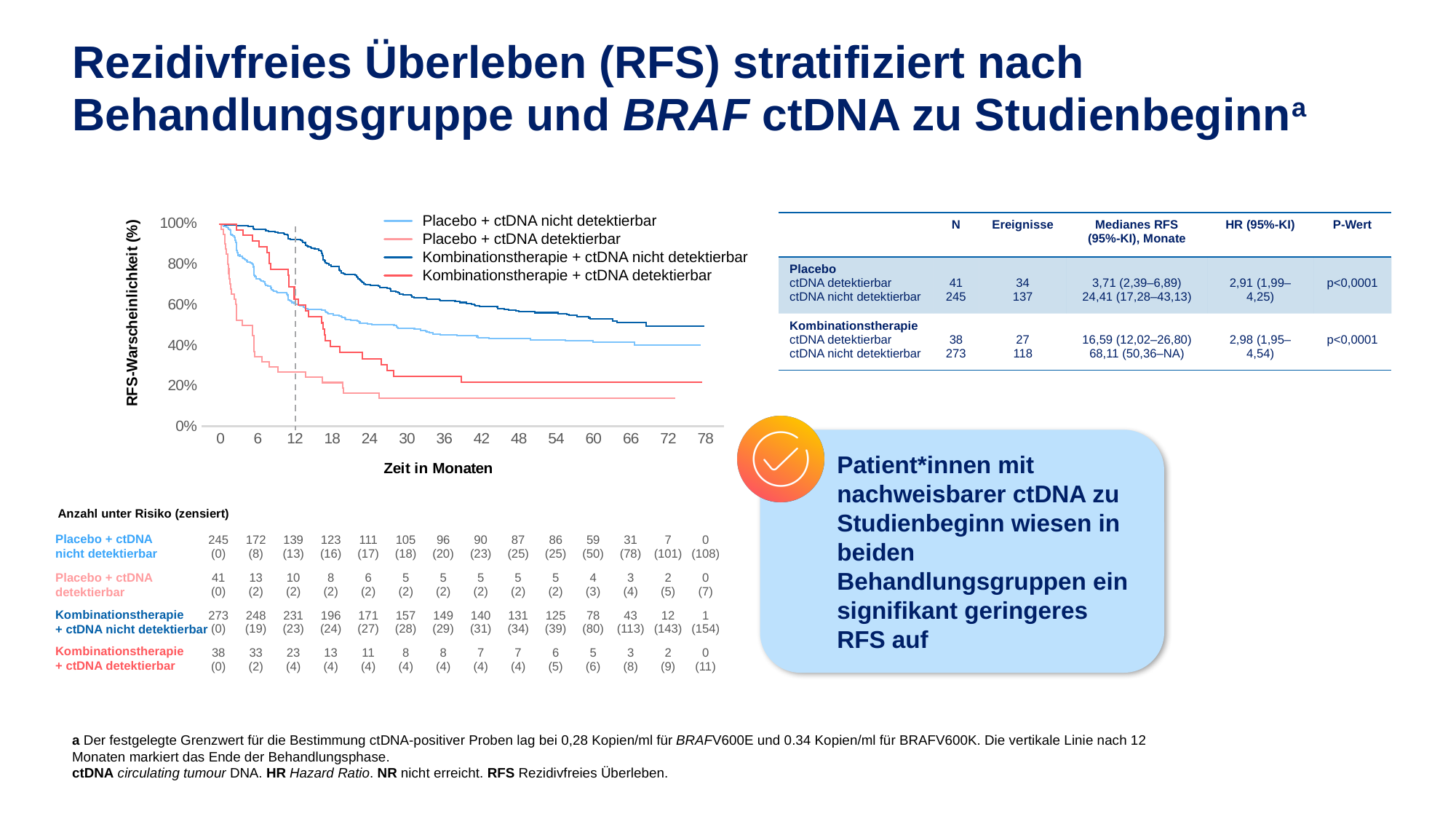
Is the RFS probability for Kombinationstherapie + ctDNA nicht detektierbar at 12 months greater or less than 80%? greater What is the label of the x axis of the RFS chart? Zeit in Monaten How many series does the legend of the RFS chart list? 4 At which month is the vertical dashed line in the RFS chart placed? 12 In the 'Anzahl unter Risiko' table below the chart, how many patients in the Placebo + ctDNA nicht detektierbar group are at risk at 0 months? 245 In the 'Anzahl unter Risiko' table below the chart, how many patients in the Kombinationstherapie + ctDNA nicht detektierbar group are at risk at 24 months? 171 Which series has the lowest RFS probability at 36 months? Placebo + ctDNA detektierbar Is the RFS probability for Kombinationstherapie + ctDNA nicht detektierbar at 72 months greater or less than 40%? greater Do the RFS curves rise or fall along the x axis? Fall Is the RFS probability for Placebo + ctDNA detektierbar at 12 months greater or less than 40%? less What kind of chart is shown on the left of the slide? Line chart (Kaplan-Meier curve) Which series has the highest RFS probability at 36 months? Kombinationstherapie + ctDNA nicht detektierbar